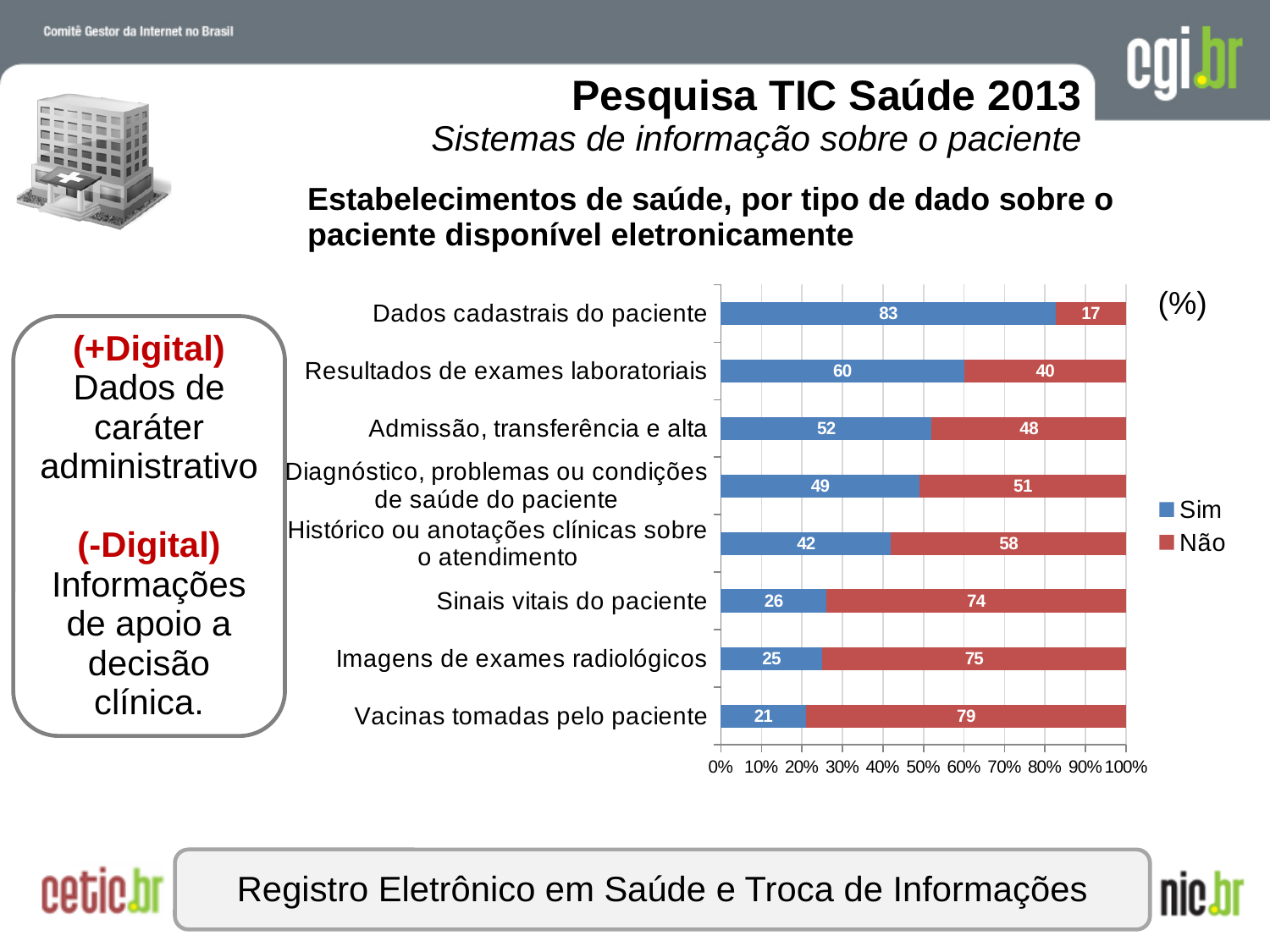
Which is larger for 'Histórico ou anotações clínicas sobre o atendimento': the 'Sim' value or the 'Não' value? Não What is the 'Sim' value for 'Vacinas tomadas pelo paciente'? 21 What kind of chart is shown on the slide? Stacked bar chart What is the 'Sim' value for 'Dados cadastrais do paciente'? 83 Which category has the highest 'Sim' value? Dados cadastrais do paciente How many categories are shown in the chart? 8 How many series does the legend list? 2 Which colour represents the 'Não' series in the chart? Red Which category has the lowest 'Sim' value? Vacinas tomadas pelo paciente What is the total of the stacked bar for 'Admissão, transferência e alta'? 100 What is the difference between the 'Sim' and 'Não' values for 'Resultados de exames laboratoriais'? 20 What is the 'Não' value for 'Sinais vitais do paciente'? 74